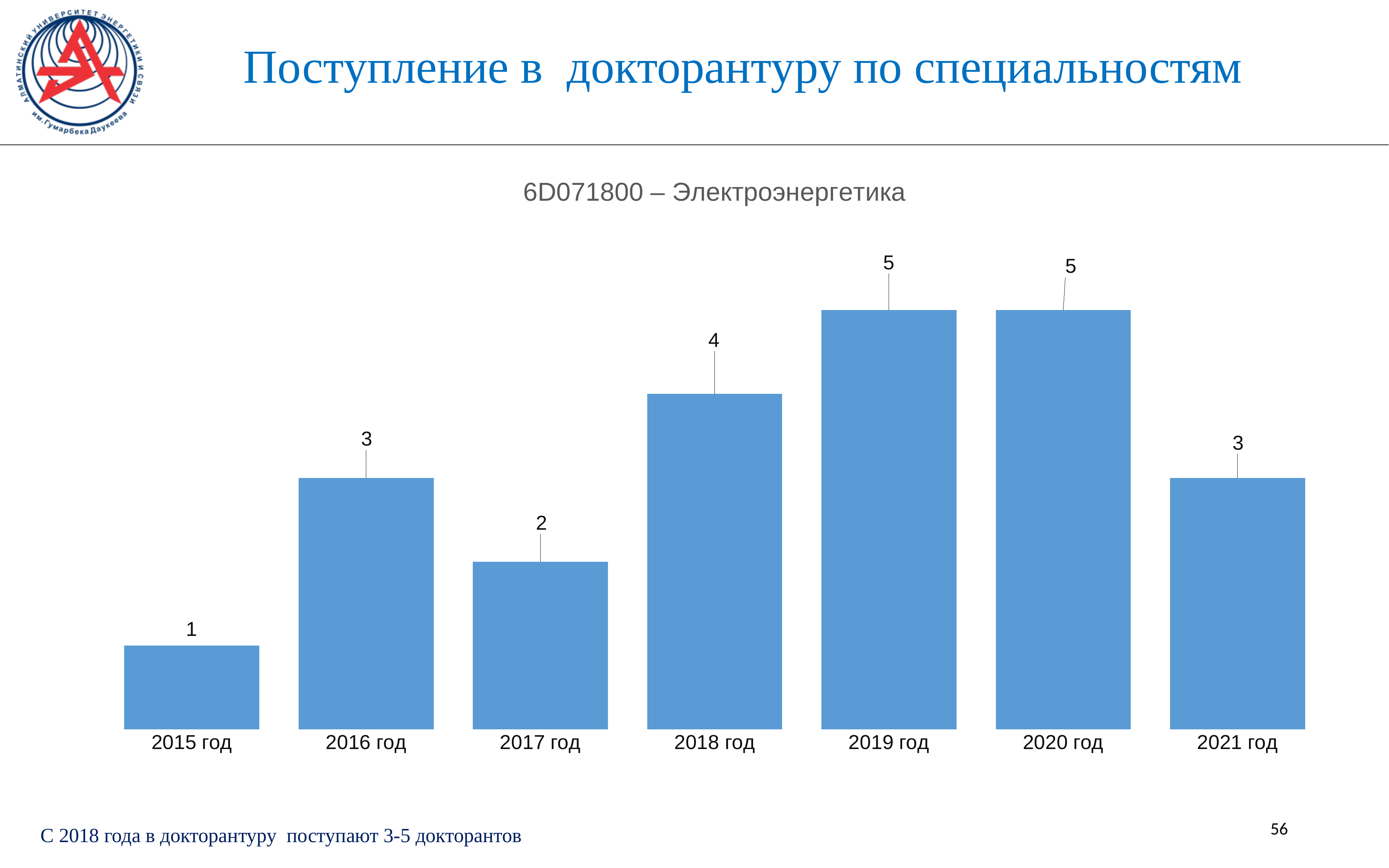
What is the value for 2015 год? 1 What is the value for 2018 год? 4 What kind of chart is shown on the slide? bar chart Do the values rise or fall from 2017 год to 2019 год? rise What is the highest value shown on the chart? 5 What is the value for 2021 год? 3 What is the difference between the values for 2018 год and 2015 год? 3 Which year has the lowest value? 2015 год How many years are shown on the chart? 7 Which is larger, the value for 2016 год or the value for 2017 год? 2016 год What is the title of the chart? 6D071800 – Электроэнергетика What is the difference between the values for 2019 год and 2017 год? 3